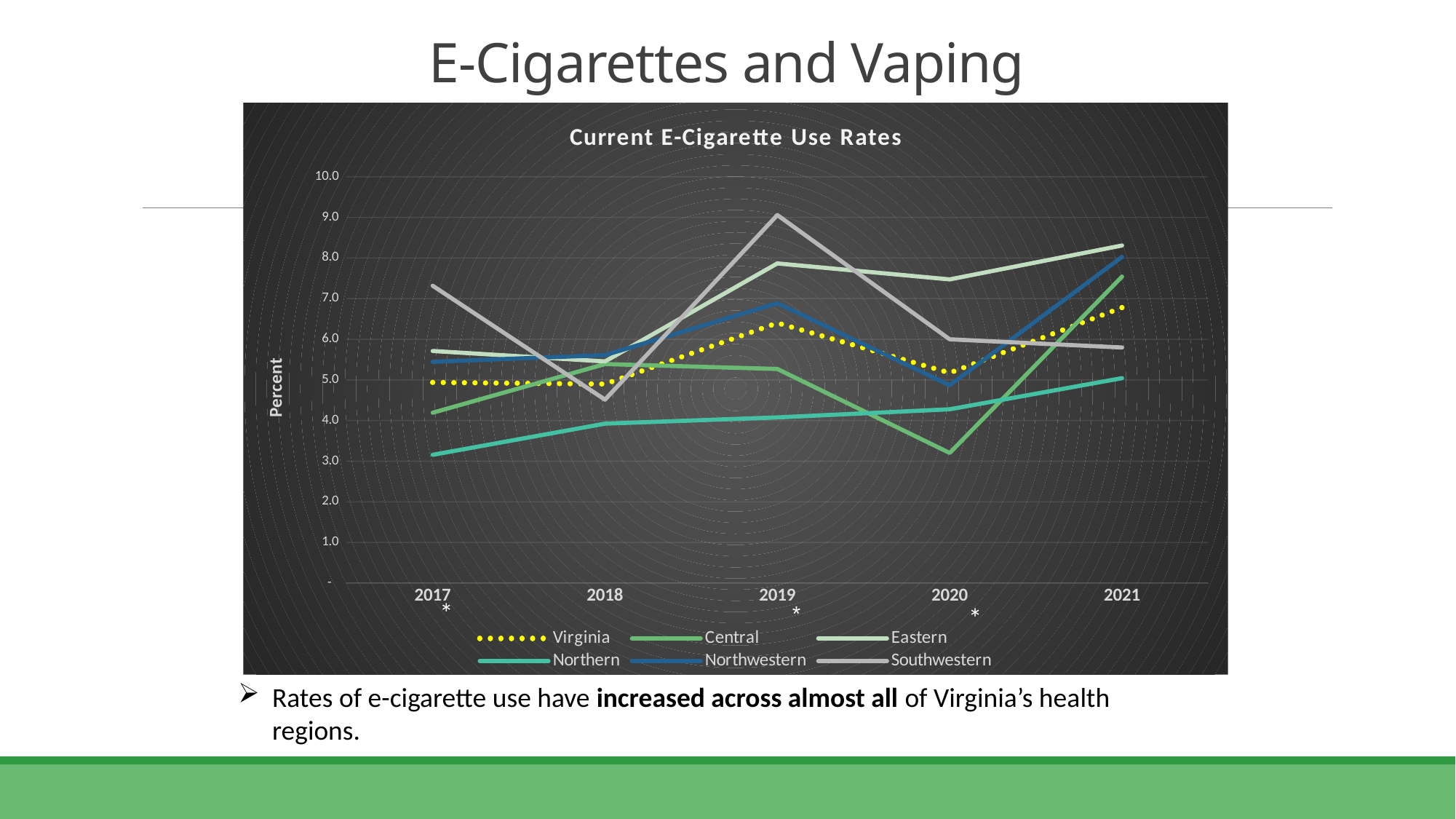
Is the value for Northern in 2017 greater or less than 4.0? less Does the Northern line rise or fall from 2017 to 2021? rise What is the title of the chart? Current E-Cigarette Use Rates Is the value for Southwestern in 2019 greater or less than 8.0? greater What kind of chart is shown on the slide? line chart What is the label on the vertical axis of the chart? Percent Which is larger in 2020, the value for Northern or the value for Central? Northern Which region has the highest value in 2019? Southwestern How many series does the legend of the chart list? 6 Which region has the lowest value in 2017? Northern Which region has the lowest value in 2020? Central How many years are shown on the x axis of the chart? 5